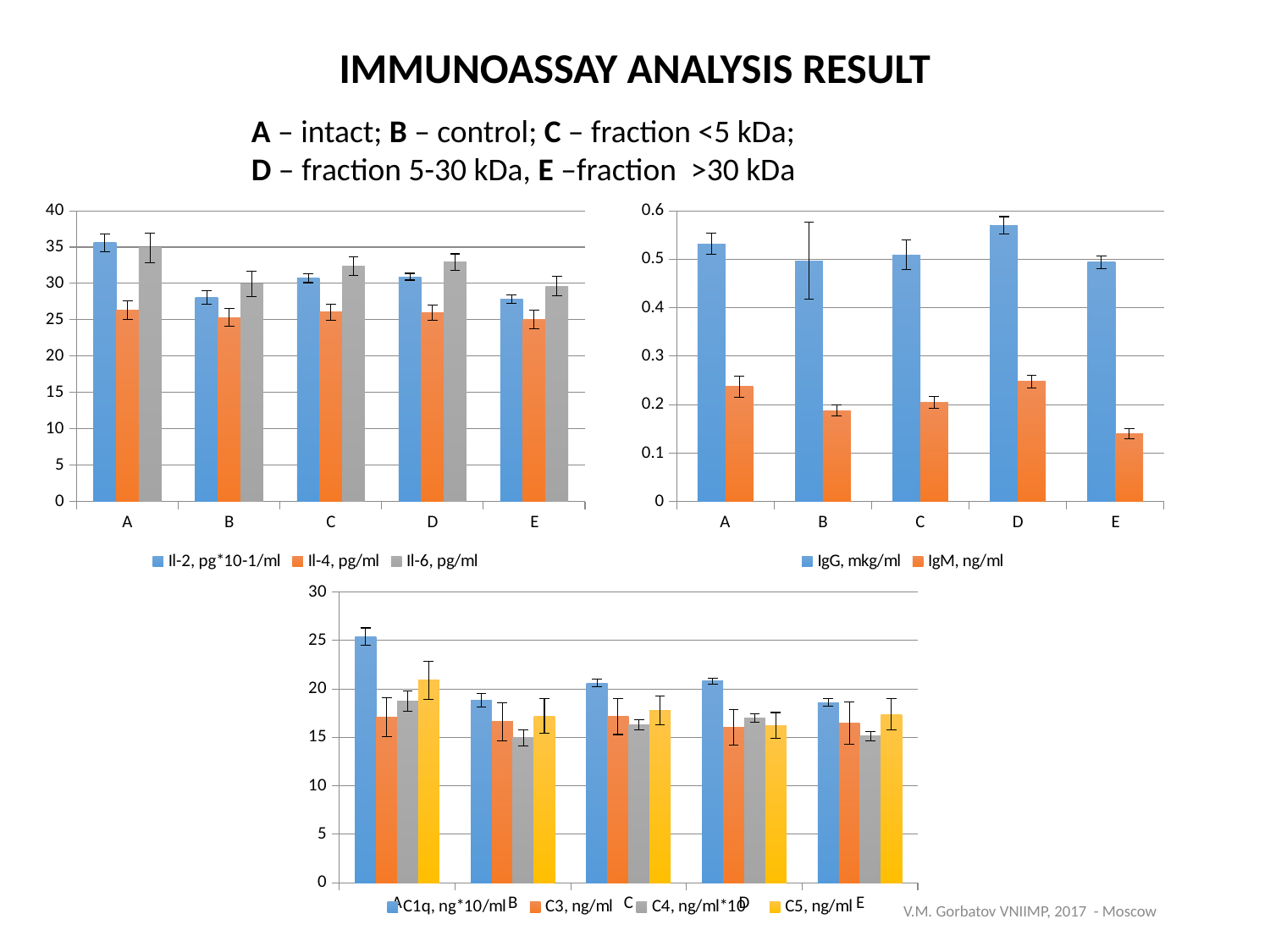
In the top-left chart (Il-2, Il-4, Il-6), is the Il-4 value for A greater or less than 25? greater How many series does the legend of the bottom chart (C1q, C3, C4, C5) list? 4 In the bottom chart (C1q, C3, C4, C5), which is larger for category A: C1q or C3? C1q In the bottom chart (C1q, C3, C4, C5), which category has the highest C1q value? A What kind of chart is the top-left chart (Il-2, Il-4, Il-6)? bar chart How many series does the legend of the top-right chart (IgG, IgM) list? 2 In the top-right chart (IgG, IgM), which category has the highest IgG value? D How many categories are shown on the x axis of the top-left chart (Il-2, Il-4, Il-6)? 5 What are the legend entries of the top-right chart? IgG, mkg/ml; IgM, ng/ml In the top-right chart (IgG, IgM), is the IgM value for A greater or less than 0.2? greater In the top-left chart (Il-2, Il-4, Il-6), which category has the highest Il-2 value? A In the top-right chart (IgG, IgM), which category has the lowest IgM value? E